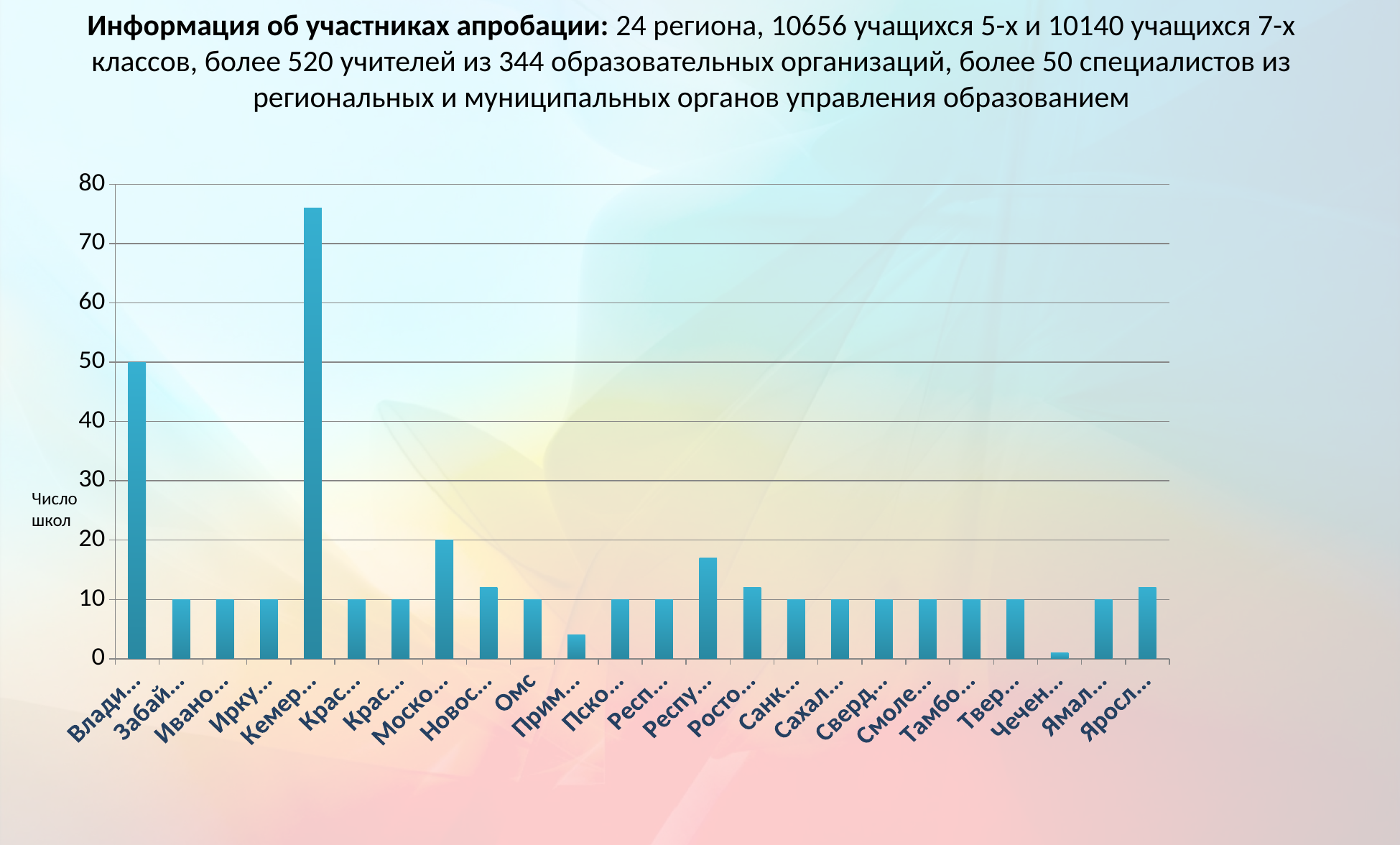
How many regions (bars) are shown in the chart? 24 Is the value for Прим… greater or less than 10? less Is the value for Моско… greater or less than 30? less What is the label on the vertical axis of the chart? Число школ Which region has the highest number of schools in the chart? Кемер… What is the value for Омс in the chart? 10 What is the value for Влади… in the chart? 50 Which region has the lowest number of schools in the chart? Чечен… Which is larger, the value for Влади… or the value for Моско…? Влади… What kind of chart is shown on the slide? bar chart Which is larger, the value for Респу… or the value for Росто…? Респу… Is the value for Кемер… greater or less than 70? greater